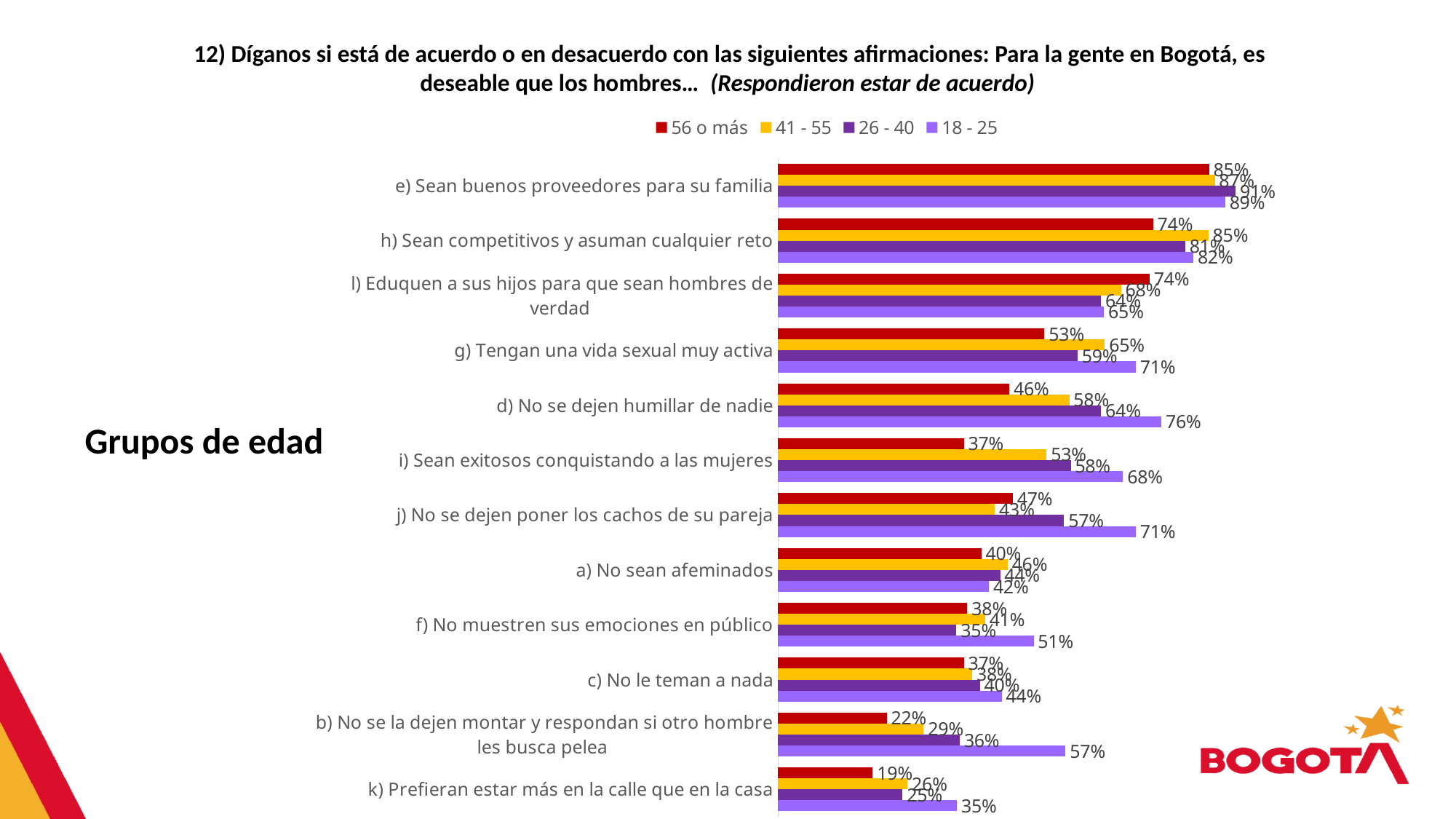
Which statement has the lowest value for the 56 o más group? k) Prefieran estar más en la calle que en la casa What is the value for the 41 - 55 group for 'h) Sean competitivos y asuman cualquier reto'? 85% Which statement has the highest value for the 18 - 25 group? e) Sean buenos proveedores para su familia What is the value for the 56 o más group for 'b) No se la dejen montar y respondan si otro hombre les busca pelea'? 22% What is the difference between the 18 - 25 and 56 o más values for 'b) No se la dejen montar y respondan si otro hombre les busca pelea'? 35% What is the value for the 18 - 25 group for 'd) No se dejen humillar de nadie'? 76% What kind of chart is shown on the slide? bar chart What is the value for the 26 - 40 group for 'j) No se dejen poner los cachos de su pareja'? 57% How many statements (categories) are plotted on the chart? 12 How many age groups does the legend list? 4 Which colour represents the 56 o más group in the legend? red For 'g) Tengan una vida sexual muy activa', which group has the larger value: 56 o más or 18 - 25? 18 - 25